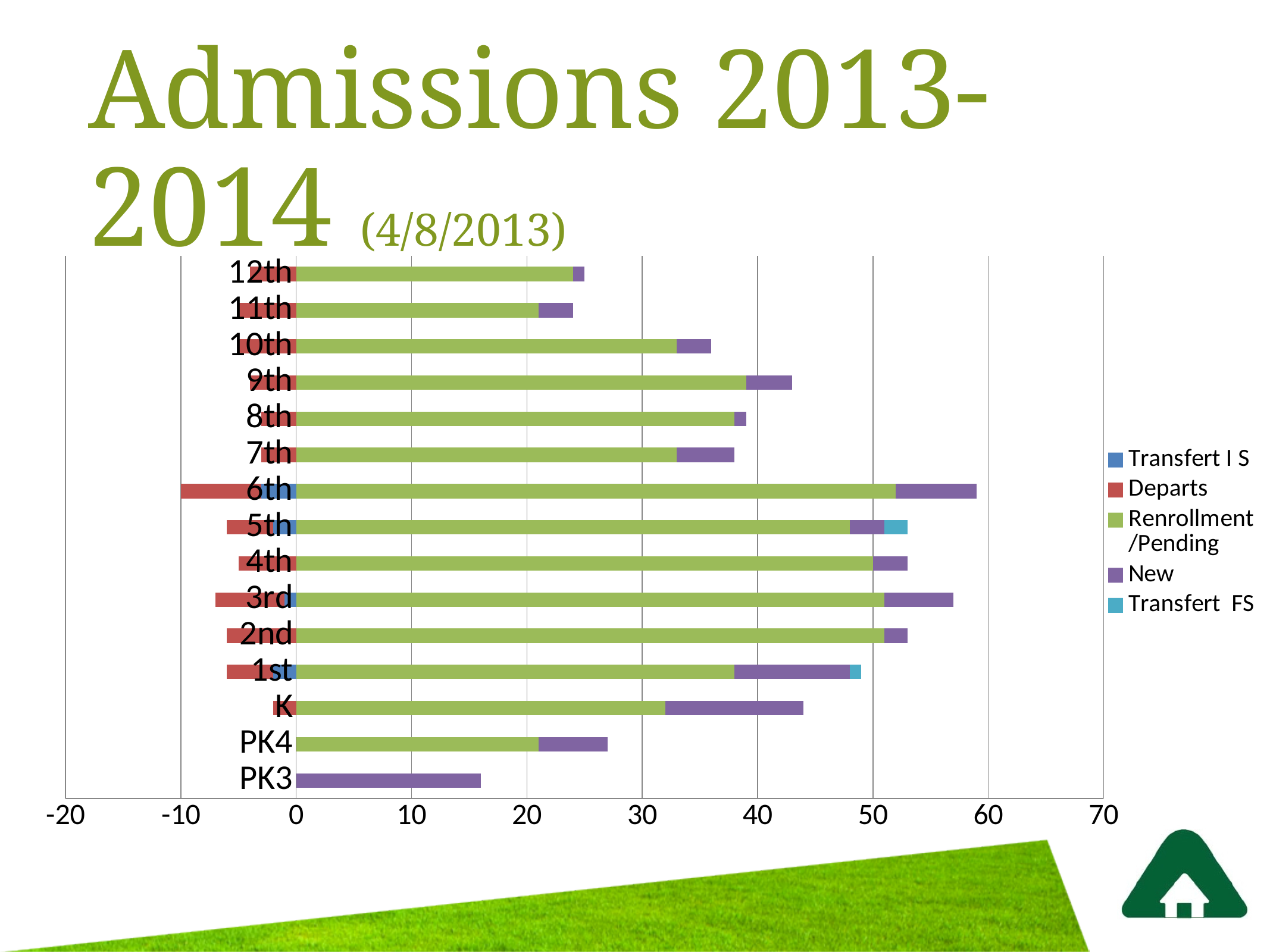
Which series is shown in light blue (cyan) in the legend? Transfert FS Is the New value for PK3 greater or less than 20? less How many series does the legend list? 5 What kind of chart is shown on the slide? bar chart Which has the larger Renrollment/Pending value, 10th or 12th? 10th Which grade has the largest Departs bar (extending furthest into the negative side)? 6th Is the Renrollment/Pending value for 12th greater or less than 30? less How many grade categories are plotted on the chart? 15 Which has the larger New value, K or 12th? K Is the Renrollment/Pending value for 9th greater or less than 30? greater Which grade has the shortest total bar on the positive side of the axis? PK3